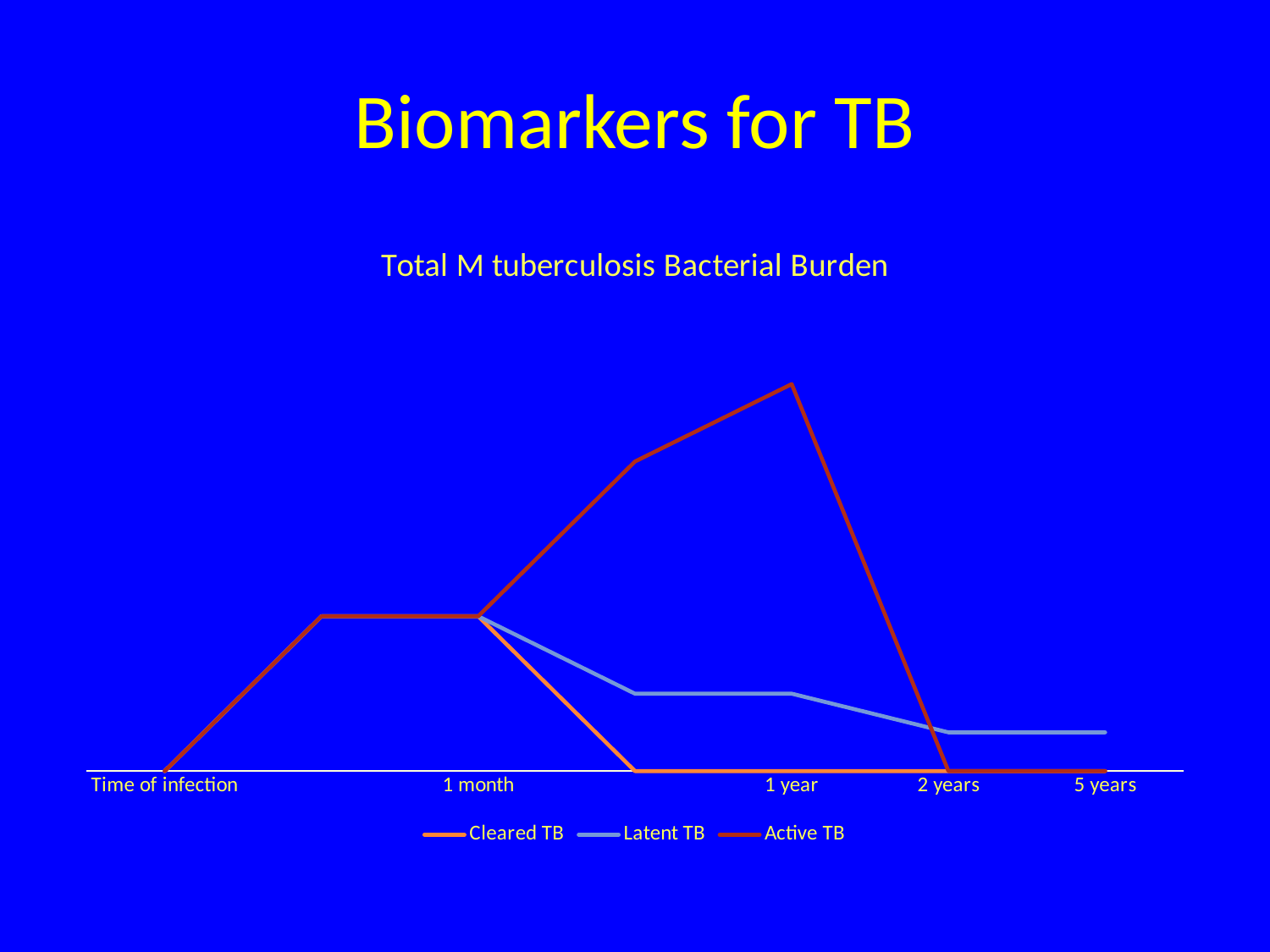
Does the Active TB line rise or fall between 1 year and 2 years? Fall At 1 year, which series has the higher value: Active TB or Latent TB? Active TB Which series are listed in the chart legend? Cleared TB, Latent TB, Active TB How many series does the legend list? 3 What is the title of the chart? Total M tuberculosis Bacterial Burden How many labelled time points are shown on the x axis? 5 Which series has the lowest value at 5 years? Cleared TB and Active TB (both at zero) Does the Latent TB line rise or fall between 1 month and 1 year? Fall Which series reaches the highest value on the chart? Active TB Does the Active TB line rise or fall between 1 month and 1 year? Rise What kind of chart is shown on the slide? Line chart At 1 year, which series has the lower value: Cleared TB or Latent TB? Cleared TB